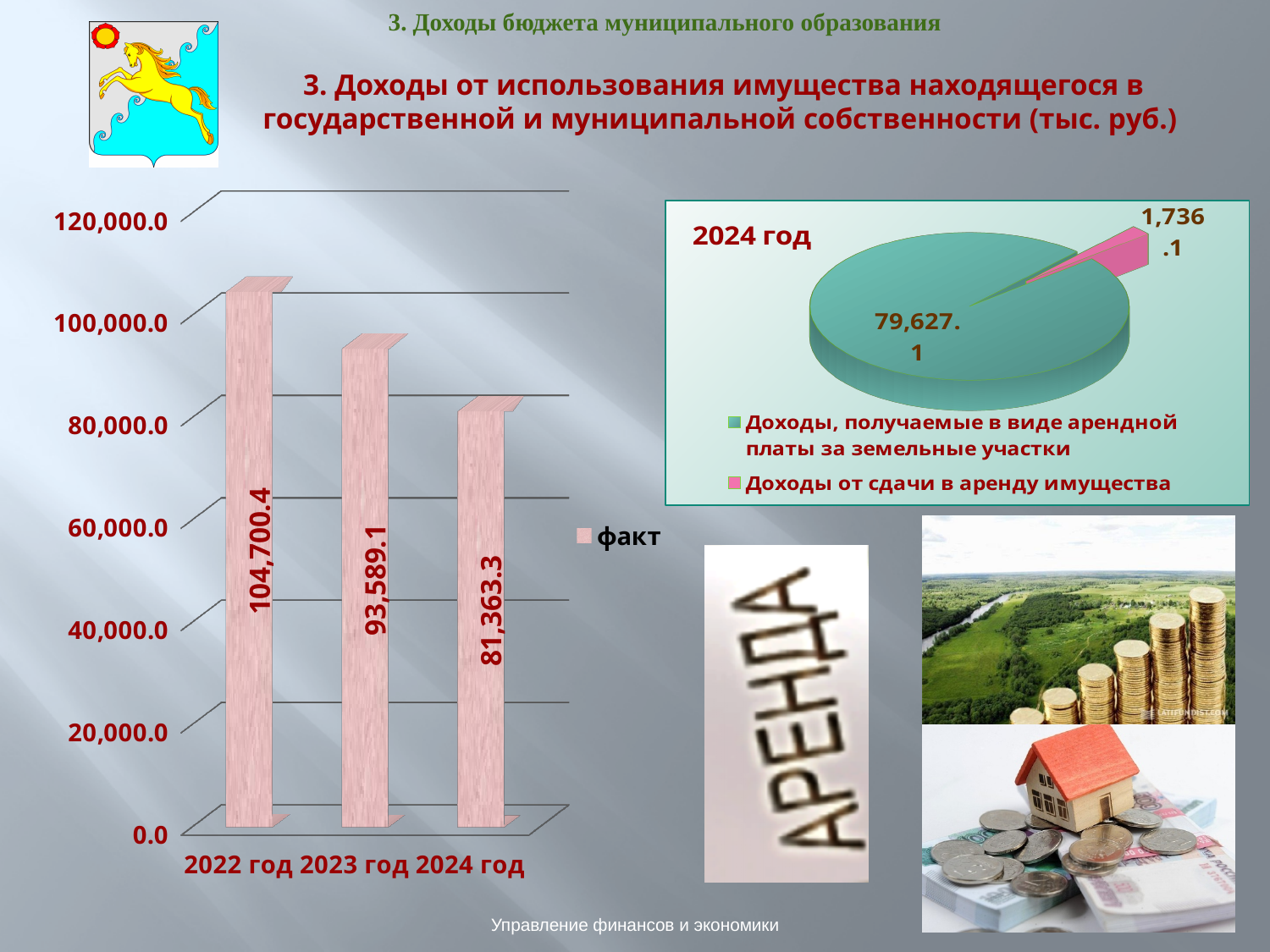
What kind of chart is the chart on the left of the slide? bar chart In the bar chart on the left, which year has the lowest value? 2024 год In the pie chart titled '2024 год', which category is larger: 'Доходы, получаемые в виде арендной платы за земельные участки' or 'Доходы от сдачи в аренду имущества'? Доходы, получаемые в виде арендной платы за земельные участки In the bar chart on the left, how many years are shown? 3 In the bar chart on the left, what is the value for 2024 год? 81,363.3 How many series does the legend of the pie chart titled '2024 год' list? 2 In the bar chart on the left, what is the value for 2022 год? 104,700.4 In the bar chart on the left, which year has the highest value? 2022 год In the bar chart on the left, do the values rise or fall from 2022 год to 2024 год? fall In the pie chart titled '2024 год', what is the value for 'Доходы от сдачи в аренду имущества'? 1,736.1 In the bar chart on the left, what is the difference between the values for 2022 год and 2023 год? 11,111.3 In the bar chart on the left, is the value for 2023 год greater or less than 100,000.0? less